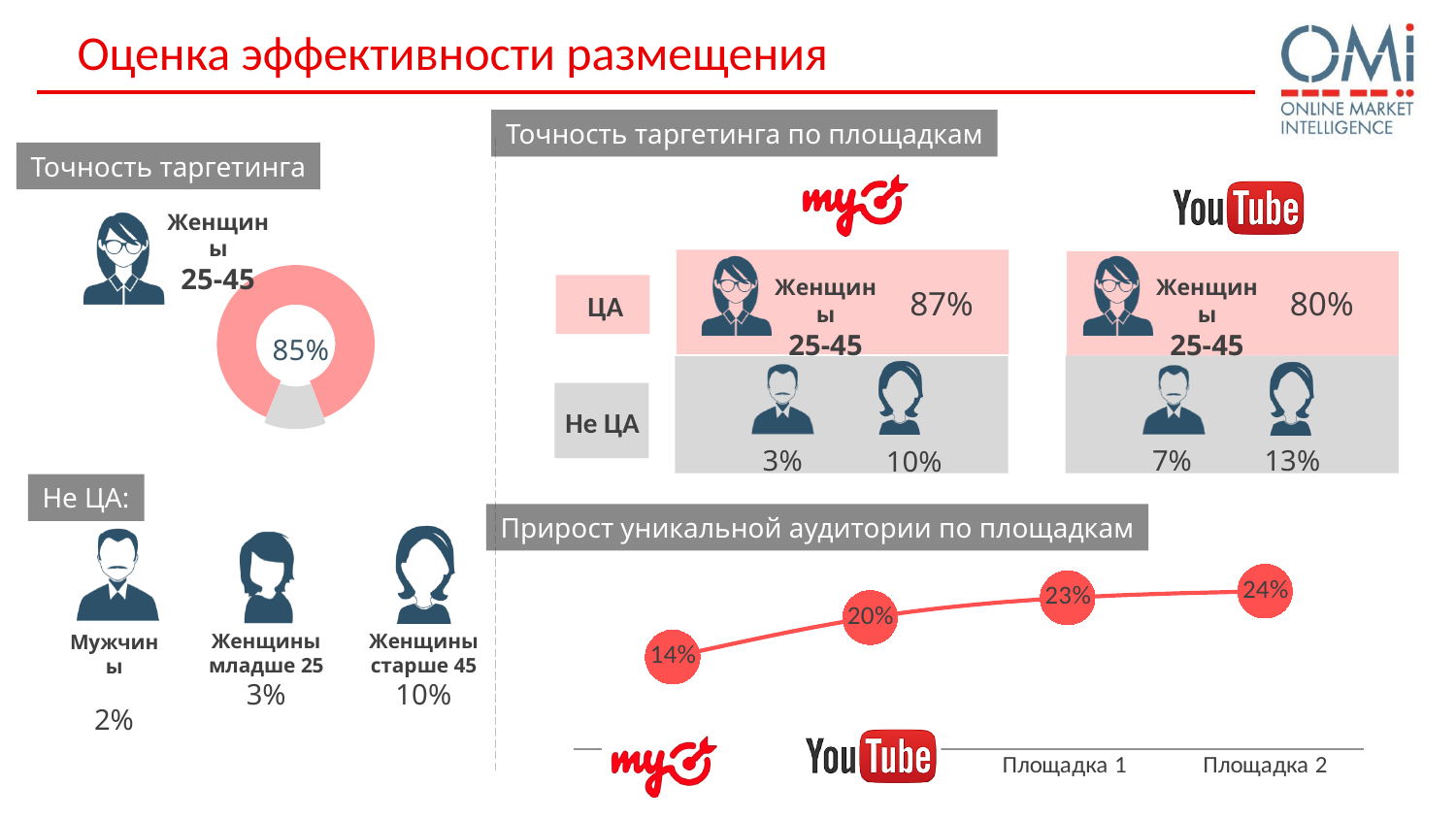
In the 'Прирост уникальной аудитории по площадкам' chart, what is the value for Площадка 1? 23% In the 'Прирост уникальной аудитории по площадкам' chart, what is the value for YouTube? 20% How many data points are plotted in the 'Прирост уникальной аудитории по площадкам' chart? 4 In the 'Прирост уникальной аудитории по площадкам' chart, what is the difference between Площадка 2 and the first platform (my)? 10% In the 'Прирост уникальной аудитории по площадкам' chart, which platform has the lowest value? my (MyTarget) In the 'Прирост уникальной аудитории по площадкам' chart, do the values rise or fall from left to right? rise In the 'Прирост уникальной аудитории по площадкам' chart, what is the value for Площадка 2? 24% In the 'Прирост уникальной аудитории по площадкам' chart, which is larger: YouTube or Площадка 1? Площадка 1 In the 'Точность таргетинга' donut chart, what share is shown for Женщины 25-45? 85% What kind of chart is 'Прирост уникальной аудитории по площадкам'? line chart In the 'Прирост уникальной аудитории по площадкам' chart, which platform has the highest value? Площадка 2 What kind of chart is shown under 'Точность таргетинга' on the left of the slide? donut (pie) chart